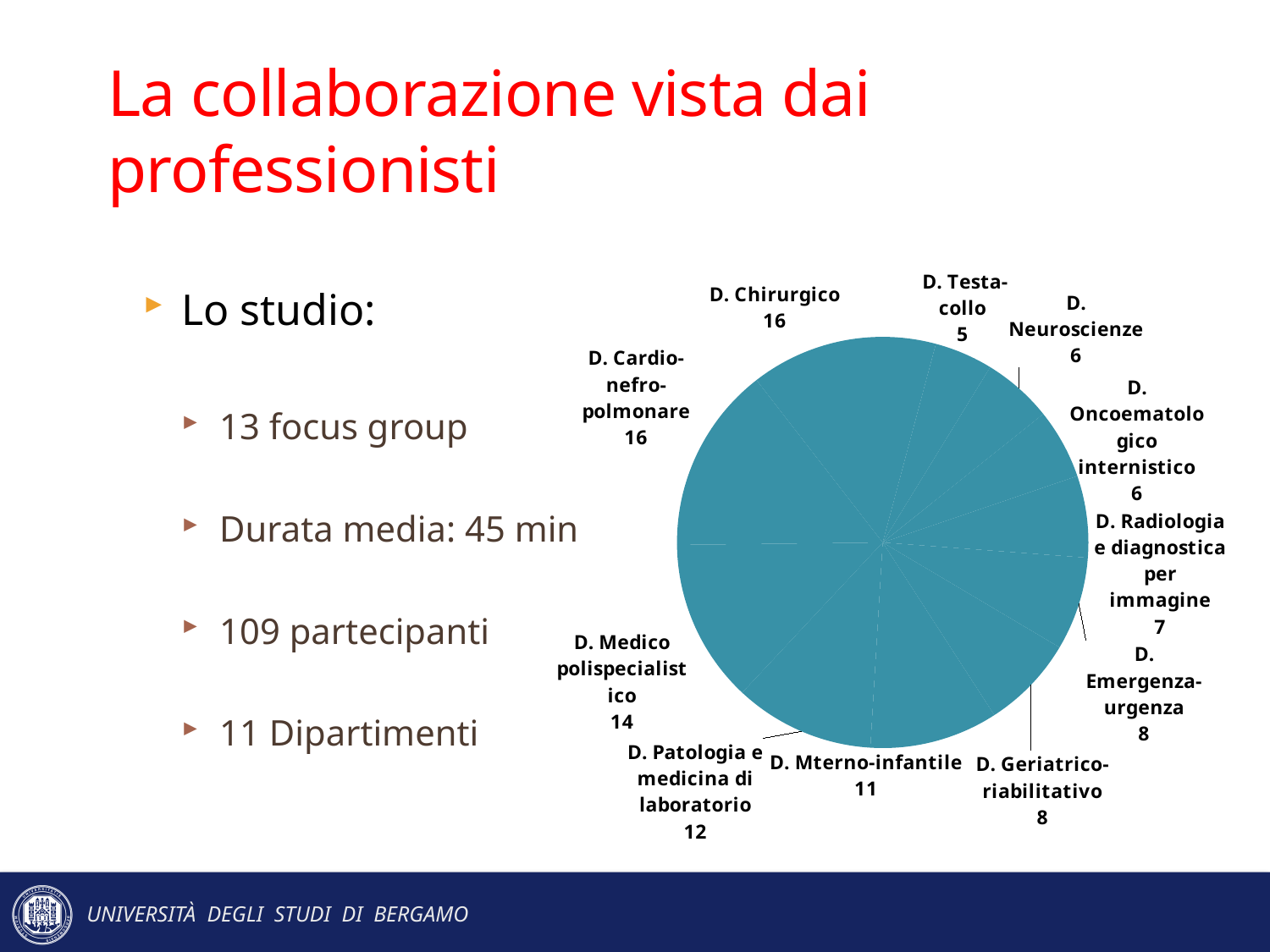
Which department has the smallest slice in the pie chart? D. Testa-collo What is the value for D. Patologia e medicina di laboratorio in the pie chart? 12 What is the value for D. Radiologia e diagnostica per immagine in the pie chart? 7 What is the difference between the values for D. Cardio-nefro-polmonare and D. Emergenza-urgenza? 8 What is the value for D. Medico polispecialistico in the pie chart? 14 What kind of chart is shown on the slide? pie chart What is the value for D. Testa-collo in the pie chart? 5 Which is larger in the pie chart: D. Medico polispecialistico or D. Mterno-infantile? D. Medico polispecialistico What is the value for D. Chirurgico in the pie chart? 16 What is the value for D. Geriatrico-riabilitativo in the pie chart? 8 How many slices does the pie chart have? 11 What is the difference between the values for D. Chirurgico and D. Testa-collo? 11